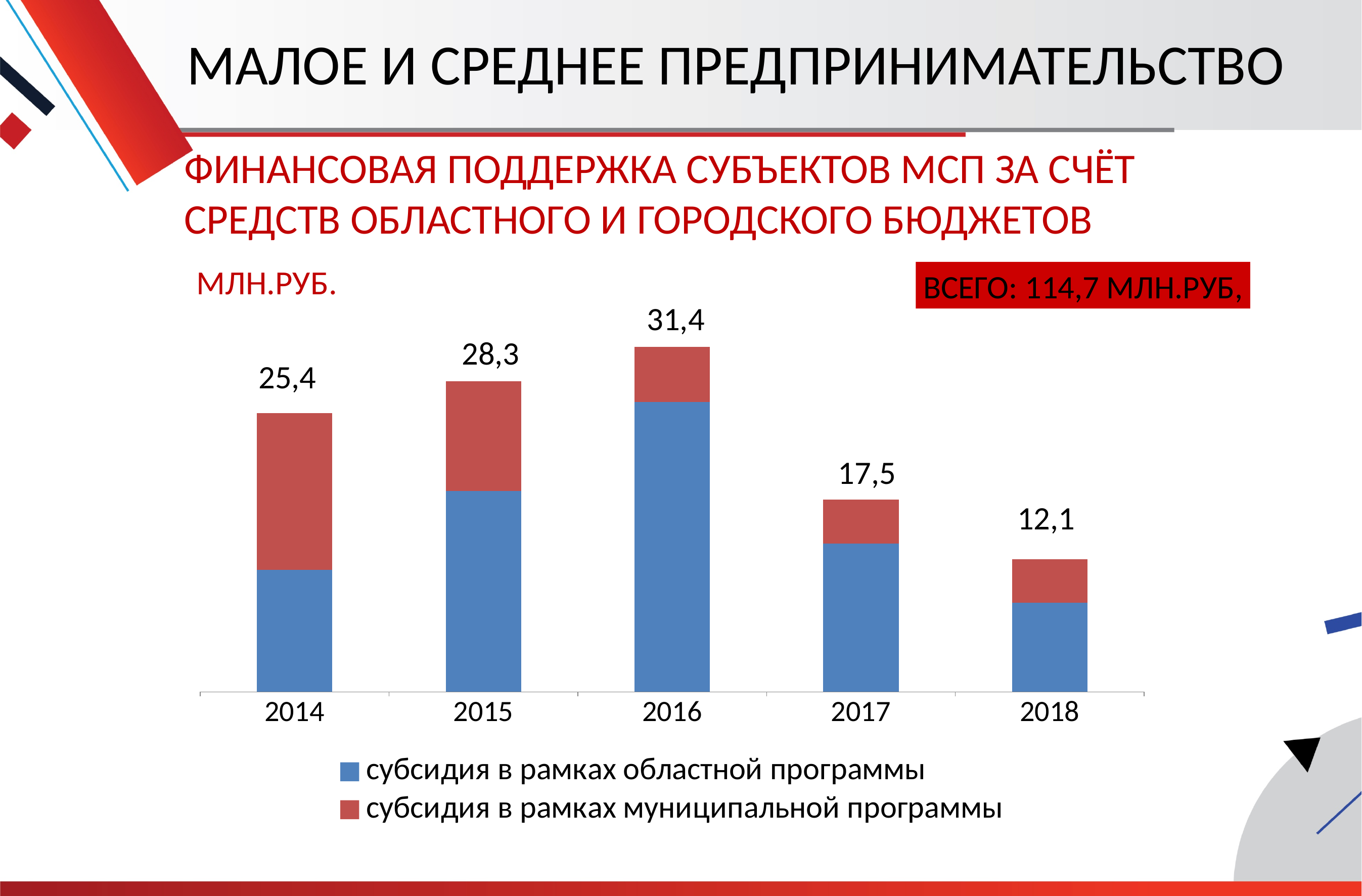
What is the total value shown for 2014? 25,4 What is the total value shown for 2016? 31,4 What kind of chart is shown on the slide? stacked bar chart What is the difference between the total values for 2015 and 2014? 2,9 Which is larger, the total for 2017 or the total for 2018? 2017 How many years are shown on the x axis? 5 How many series does the legend list? 2 Which year has the highest total value? 2016 What is the difference between the total values for 2016 and 2017? 13,9 Which year has the lowest total value? 2018 What is the total value shown for 2018? 12,1 In 2014, which segment is larger: the regional programme subsidy (blue) or the municipal programme subsidy (red)? субсидия в рамках муниципальной программы